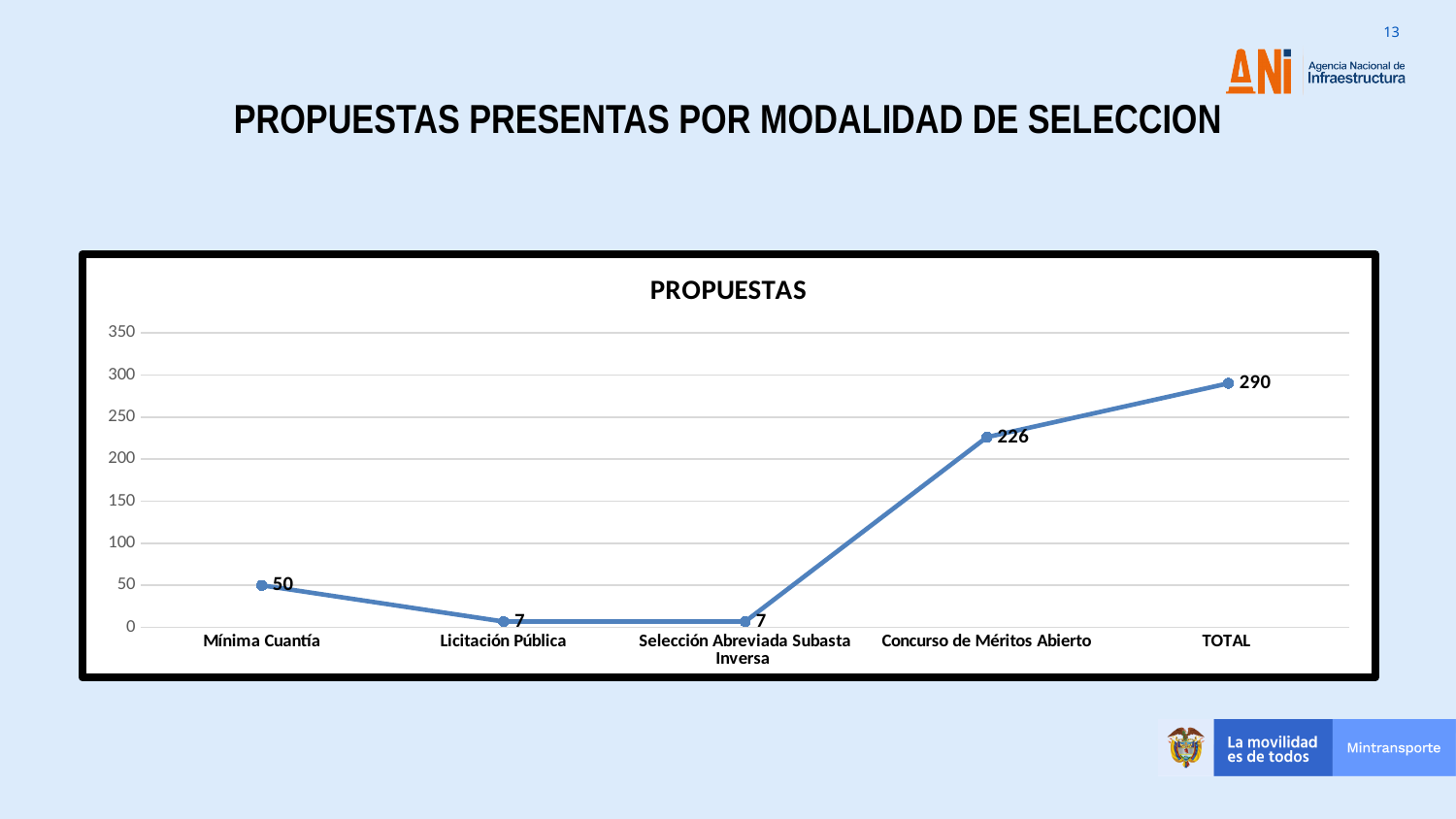
What is the value for TOTAL? 290 What is the value for Mínima Cuantía? 50 What is the value for Licitación Pública? 7 Which is larger, the value for Mínima Cuantía or the value for Selección Abreviada Subasta Inversa? Mínima Cuantía Is the value for Concurso de Méritos Abierto greater or less than 200? greater How many categories are shown on the x axis? 5 What is the value for Concurso de Méritos Abierto? 226 Which category has the highest value? TOTAL What is the difference between the values for TOTAL and Concurso de Méritos Abierto? 64 What kind of chart is shown? line chart What is the title of the chart? PROPUESTAS What is the difference between the values for Mínima Cuantía and Licitación Pública? 43